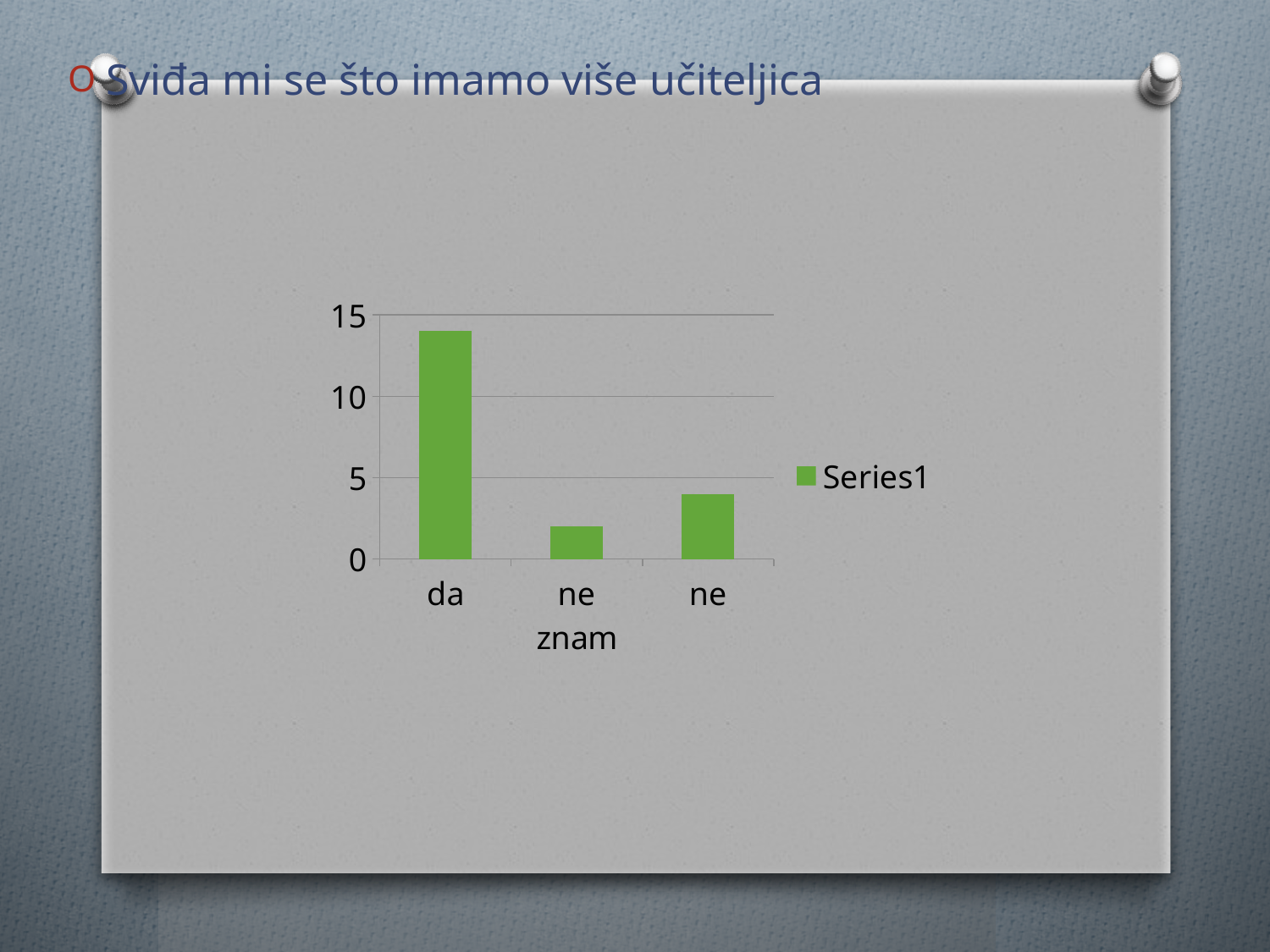
What is the name of the series shown in the chart legend? Series1 Which category has the highest bar in the chart? da What kind of chart is shown on the slide? bar chart Is the value for "ne znam" greater or less than 5? less How many categories are shown on the x axis of the chart? 3 What colour are the bars in the chart? green How many series does the chart legend list? 1 Which is larger, the value for "ne" or the value for "ne znam"? ne Is the value for "ne" greater or less than 5? less Is the value for "da" greater or less than 10? greater Which category has the lowest bar in the chart? ne znam Which is larger, the value for "da" or the value for "ne"? da